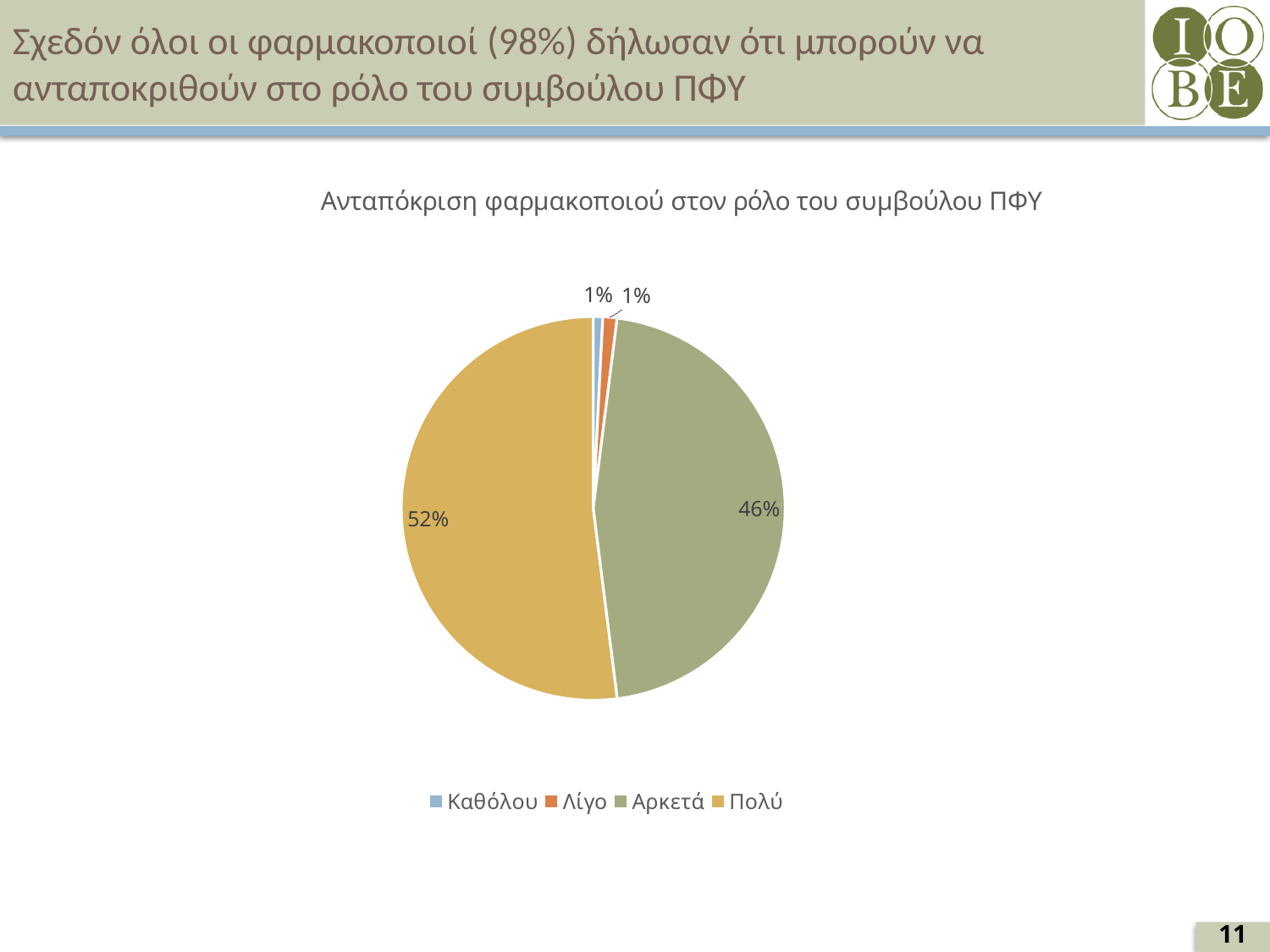
What share of the pie does the 'Πολύ' slice represent? 52% Which is larger, the 'Αρκετά' share or the 'Πολύ' share? Πολύ What colour is the 'Αρκετά' slice? Green What is the combined share of 'Αρκετά' and 'Πολύ'? 98% How many categories does the legend list? 4 What is the title of the chart? Ανταπόκριση φαρμακοποιού στον ρόλο του συμβούλου ΠΦΥ Which category has the largest slice of the pie? Πολύ What is the difference between the 'Πολύ' and 'Αρκετά' shares? 6% What share of the pie does the 'Αρκετά' slice represent? 46% What kind of chart is shown on the slide? Pie chart What share of the pie does the 'Καθόλου' slice represent? 1%